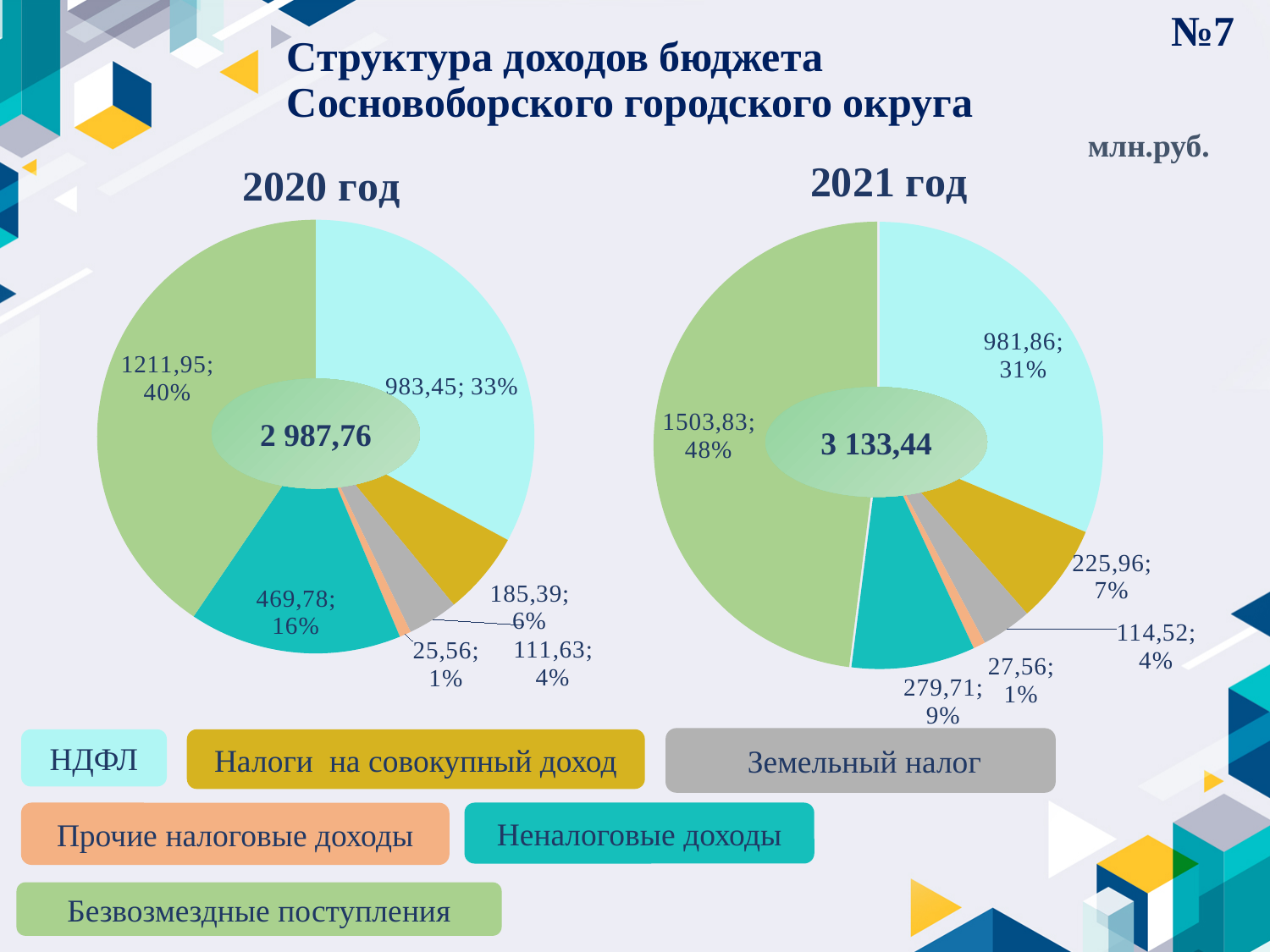
On the 2020 год pie chart, which category has the smallest slice? Прочие налоговые доходы On the 2020 год pie chart, what is the value for Безвозмездные поступления? 1211,95 On the 2021 год pie chart, what share of the pie does Безвозмездные поступления take? 48% On the 2021 год pie chart, what is the value for НДФЛ? 981,86 What total is shown in the centre of the 2020 год pie chart? 2 987,76 How many categories does the legend list for the pie charts? 6 What type of chart is used for 2020 год and 2021 год? Pie chart What is the difference between the Неналоговые доходы value on the 2020 год chart and on the 2021 год chart? 190,07 On the 2021 год pie chart, which category has the largest slice? Безвозмездные поступления Which is larger: Налоги на совокупный доход on the 2020 год chart or on the 2021 год chart? 2021 год What total is shown in the centre of the 2021 год pie chart? 3 133,44 On the 2020 год pie chart, what share of the pie does Неналоговые доходы take? 16%